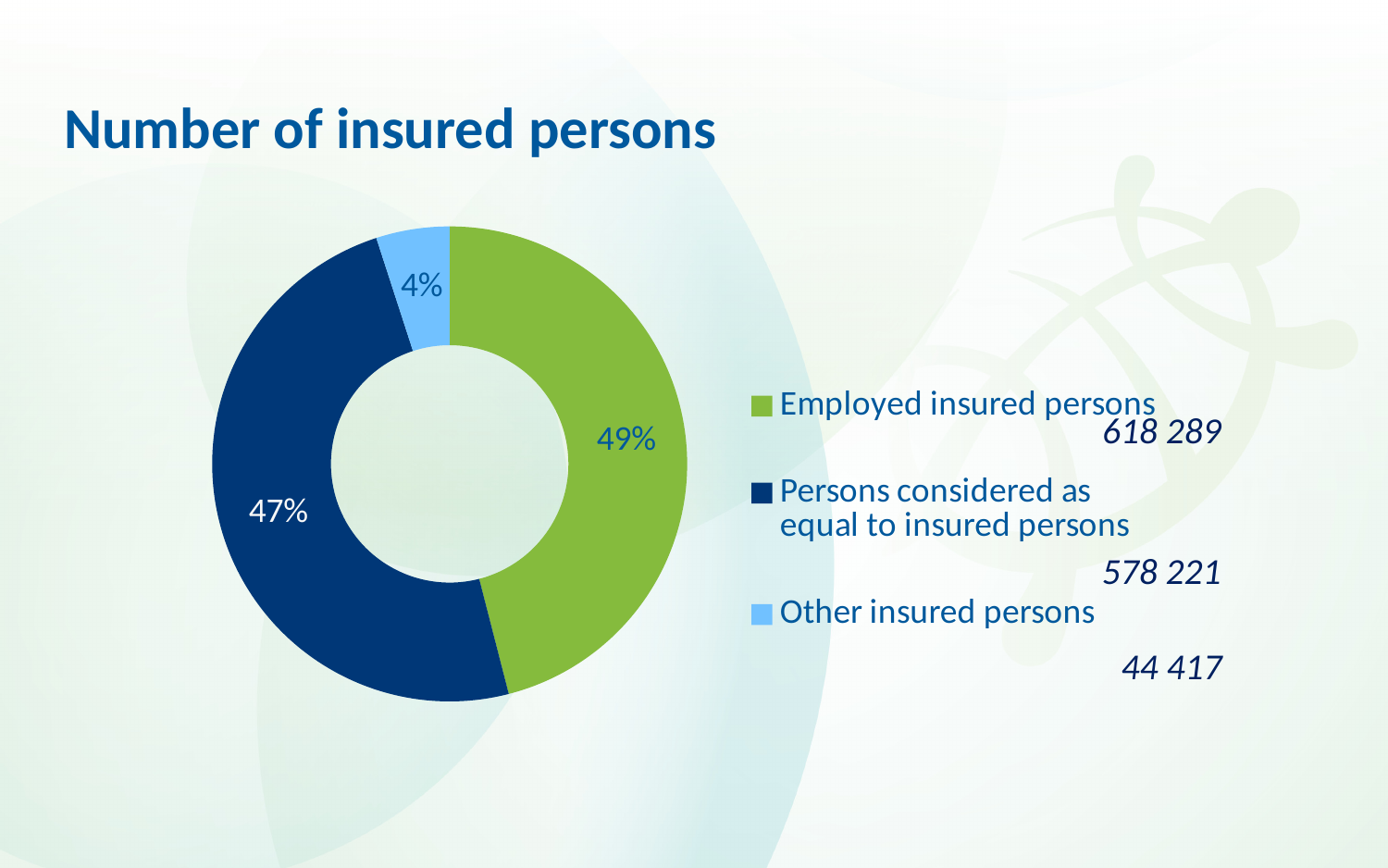
What is the difference in percentage points between the Employed insured persons slice and the Persons considered as equal to insured persons slice? 2% What share of the pie does Persons considered as equal to insured persons represent? 47% What is the number of Persons considered as equal to insured persons shown next to the legend? 578 221 What kind of chart is shown on the slide? Pie (doughnut) chart Which category has the largest share of the pie? Employed insured persons What is the title of the slide containing the chart? Number of insured persons What share of the pie does Employed insured persons represent? 49% Which category has the smallest share of the pie? Other insured persons What share of the pie does Other insured persons represent? 4% What is the number of Employed insured persons shown next to the legend? 618 289 How many categories does the pie chart show? 3 What is the number of Other insured persons shown next to the legend? 44 417